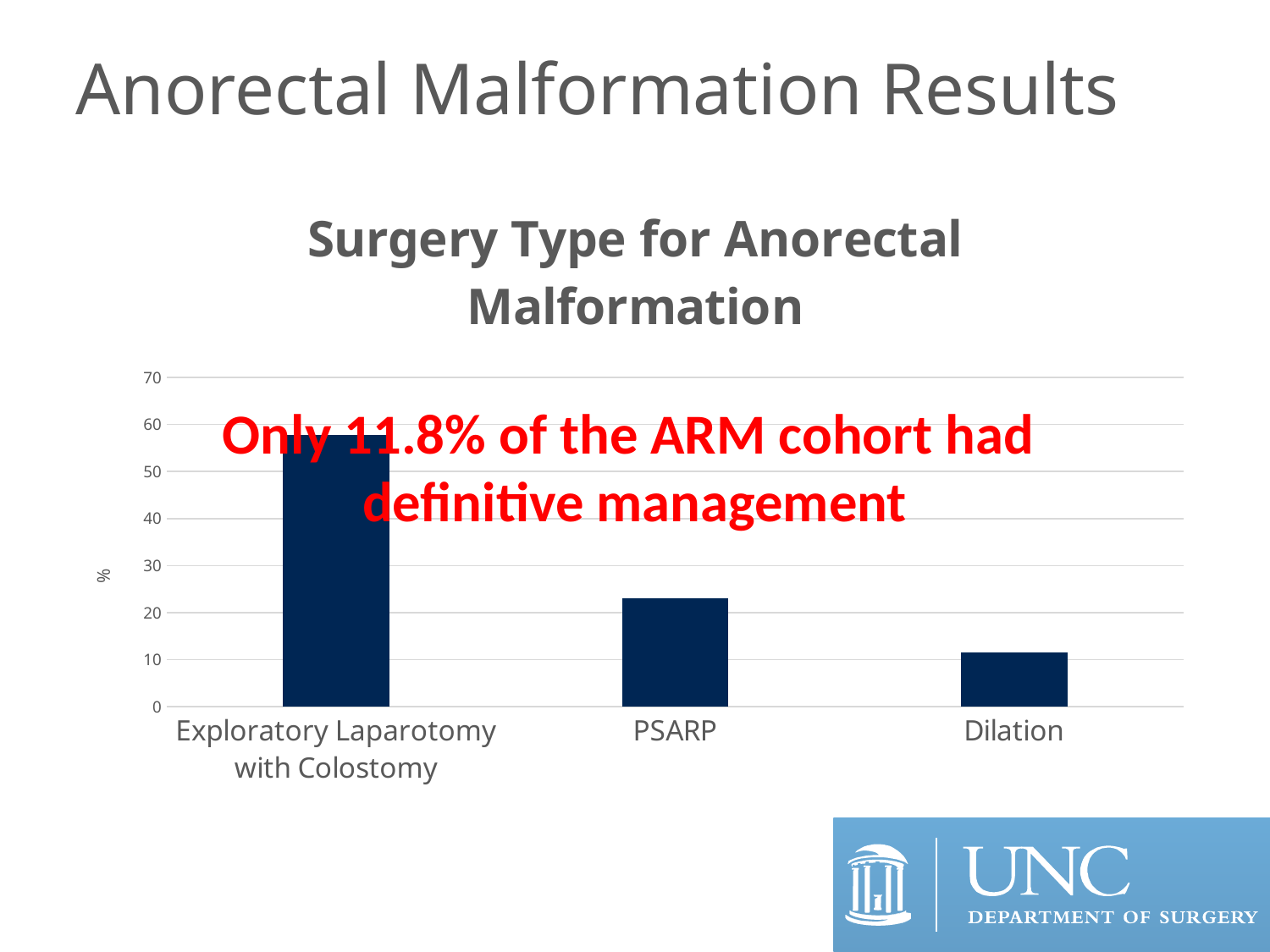
Which surgery type has the lowest percentage? Dilation What is the title of the chart? Surgery Type for Anorectal Malformation What kind of chart is shown on the slide? bar chart Do the bar values rise or fall from left to right across the x axis? fall Which has a higher percentage, PSARP or Dilation? PSARP Is the value for Dilation greater or less than 20? less Which has a higher percentage, Exploratory Laparotomy with Colostomy or PSARP? Exploratory Laparotomy with Colostomy Which surgery type has the highest percentage? Exploratory Laparotomy with Colostomy How many surgery types are plotted in the chart? 3 Is the value for Exploratory Laparotomy with Colostomy greater or less than 50? greater Is the value for PSARP greater or less than 30? less